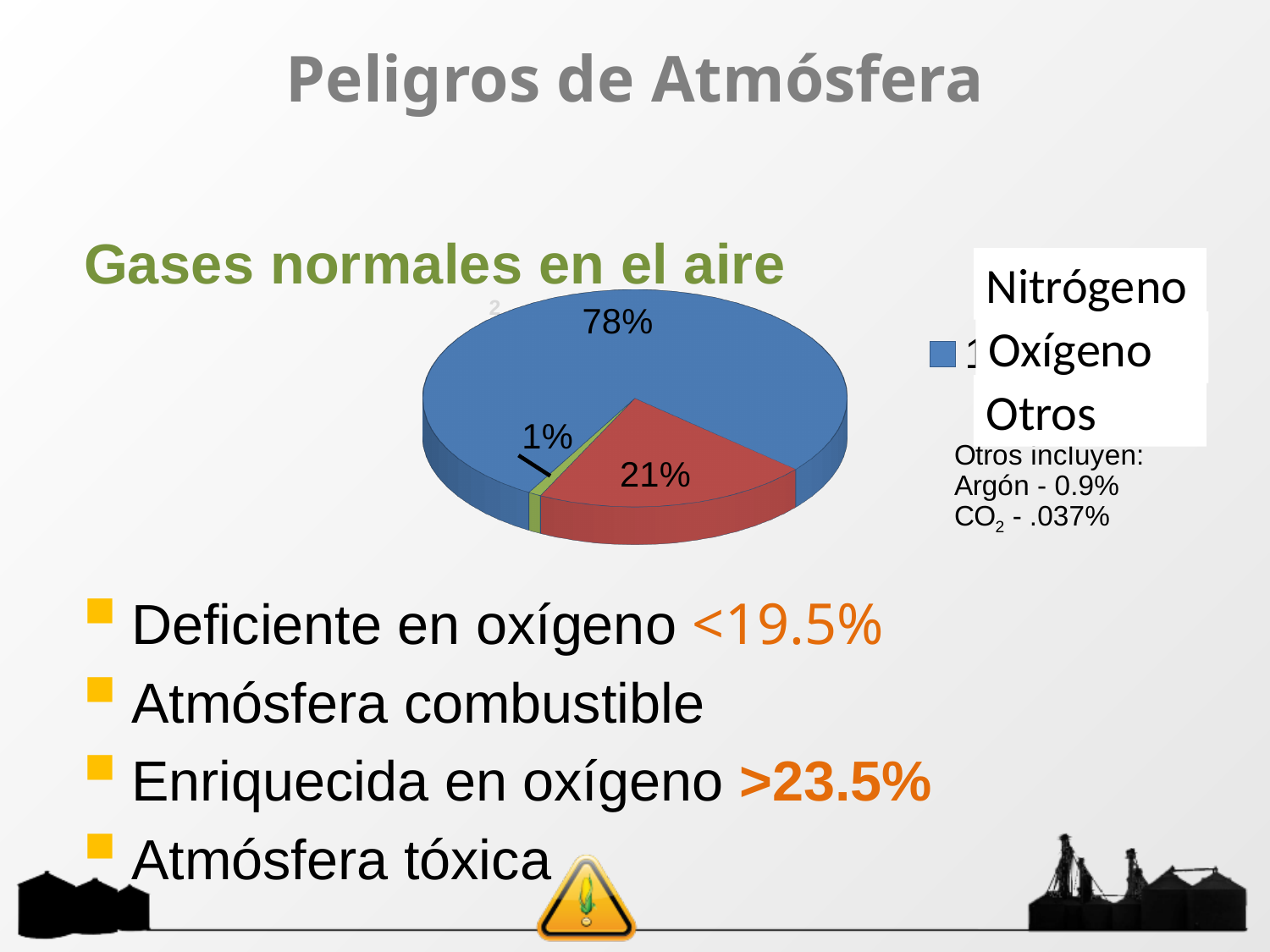
How many slices does the pie chart have? 3 Which gas has the smallest slice of the pie? Otros How many entries does the legend list? 3 What colour is the Nitrógeno slice? blue What kind of chart is shown on the slide? pie chart What is the title of the pie chart? Gases normales en el aire What share of the pie does Otros represent? 1% Which is larger, the Oxígeno slice or the Otros slice? Oxígeno What is the difference between the Nitrógeno and Oxígeno shares? 57% Which gas has the largest slice of the pie? Nitrógeno What share of the pie does Nitrógeno represent? 78% What share of the pie does Oxígeno represent? 21%